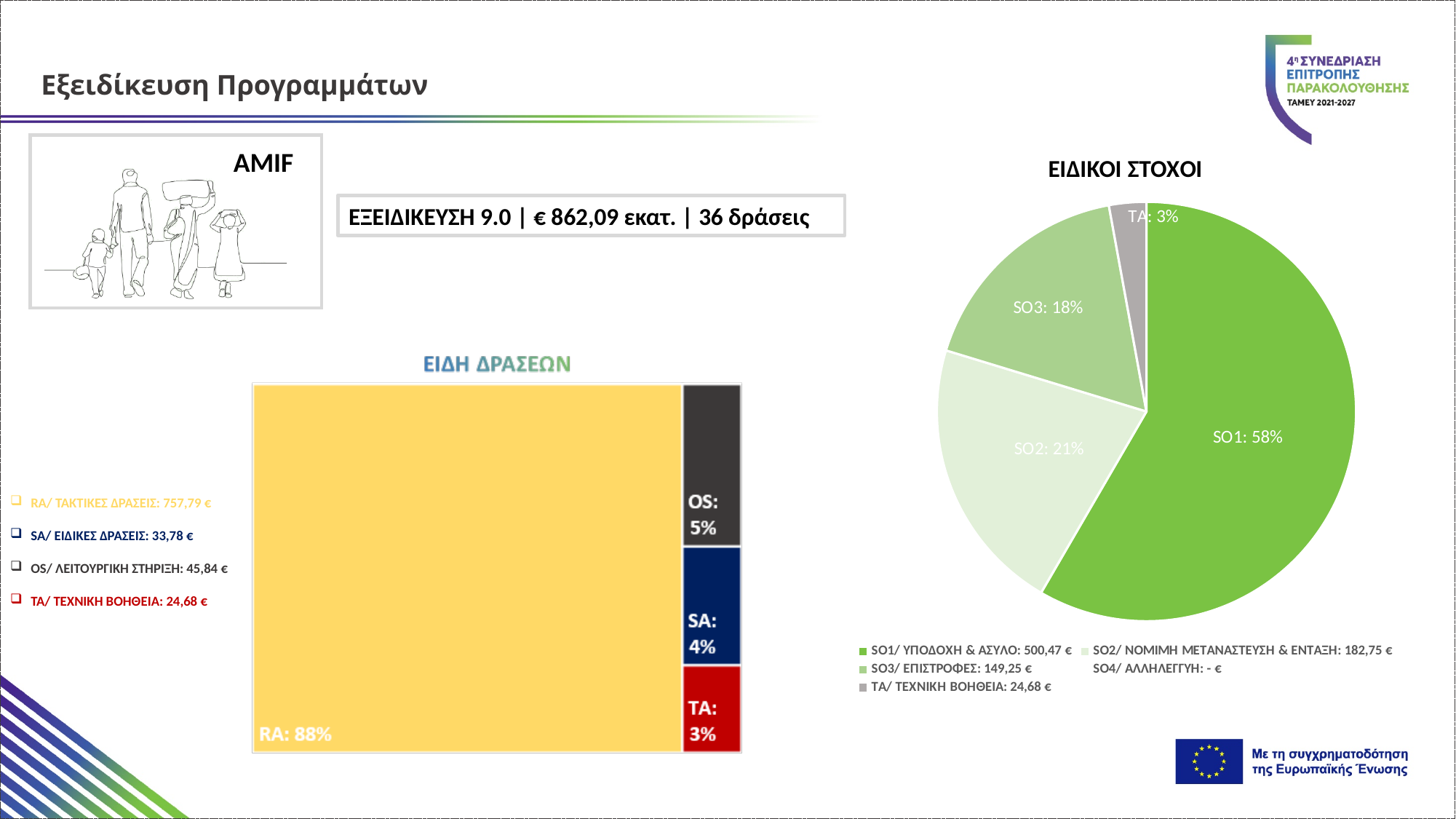
What kind of chart is the ΕΙΔΙΚΟΙ ΣΤΟΧΟΙ chart? Pie chart In the ΕΙΔΗ ΔΡΑΣΕΩΝ chart, what percentage is shown for OS? 5% In the ΕΙΔΙΚΟΙ ΣΤΟΧΟΙ pie chart, which slice is the smallest? TA In the ΕΙΔΙΚΟΙ ΣΤΟΧΟΙ pie chart, what share does SO1 have? 58% In the ΕΙΔΙΚΟΙ ΣΤΟΧΟΙ chart legend, what amount is given for SO1/ ΥΠΟΔΟΧΗ & ΑΣΥΛΟ? 500,47 € In the ΕΙΔΙΚΟΙ ΣΤΟΧΟΙ pie chart, which slice is the largest? SO1 In the ΕΙΔΗ ΔΡΑΣΕΩΝ chart, how many categories are shown? 4 In the ΕΙΔΙΚΟΙ ΣΤΟΧΟΙ pie chart, what share does SO3 have? 18% In the ΕΙΔΗ ΔΡΑΣΕΩΝ chart, which is larger, SA or TA? SA In the ΕΙΔΙΚΟΙ ΣΤΟΧΟΙ pie chart, what is the difference in percentage points between SO2 and SO3? 3 In the ΕΙΔΙΚΟΙ ΣΤΟΧΟΙ chart legend, what amount is given for SO3/ ΕΠΙΣΤΡΟΦΕΣ? 149,25 € In the ΕΙΔΗ ΔΡΑΣΕΩΝ chart, what percentage is shown for RA? 88%